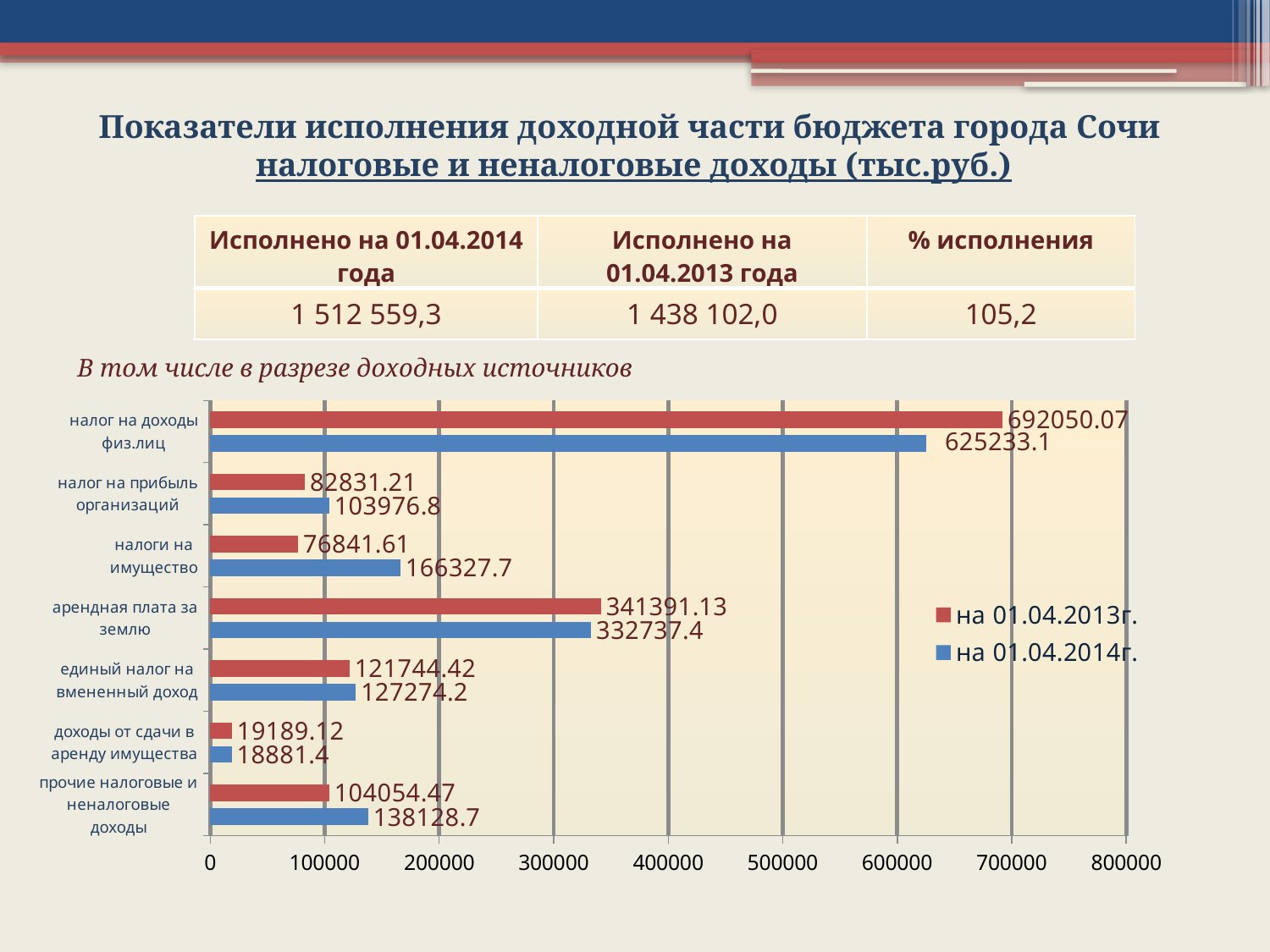
What is the value for арендная плата за землю in the series на 01.04.2013г.? 341391.13 Which category has the highest value in the series на 01.04.2013г.? налог на доходы физ.лиц Is the value for арендная плата за землю in the series на 01.04.2014г. greater or less than 300000? greater What is the value for налог на доходы физ.лиц in the series на 01.04.2014г.? 625233.1 Which category has the lowest value in the series на 01.04.2014г.? доходы от сдачи в аренду имущества What is the value for прочие налоговые и неналоговые доходы in the series на 01.04.2014г.? 138128.7 What is the difference between the на 01.04.2014г. and на 01.04.2013г. values for налоги на имущество? 89486.09 How many series does the chart legend list? 2 How many categories are shown on the chart? 7 What kind of chart is shown on the slide? bar chart What is the difference between the на 01.04.2013г. and на 01.04.2014г. values for налог на доходы физ.лиц? 66816.97 For налог на прибыль организаций, which series has the larger value: на 01.04.2013г. or на 01.04.2014г.? на 01.04.2014г.